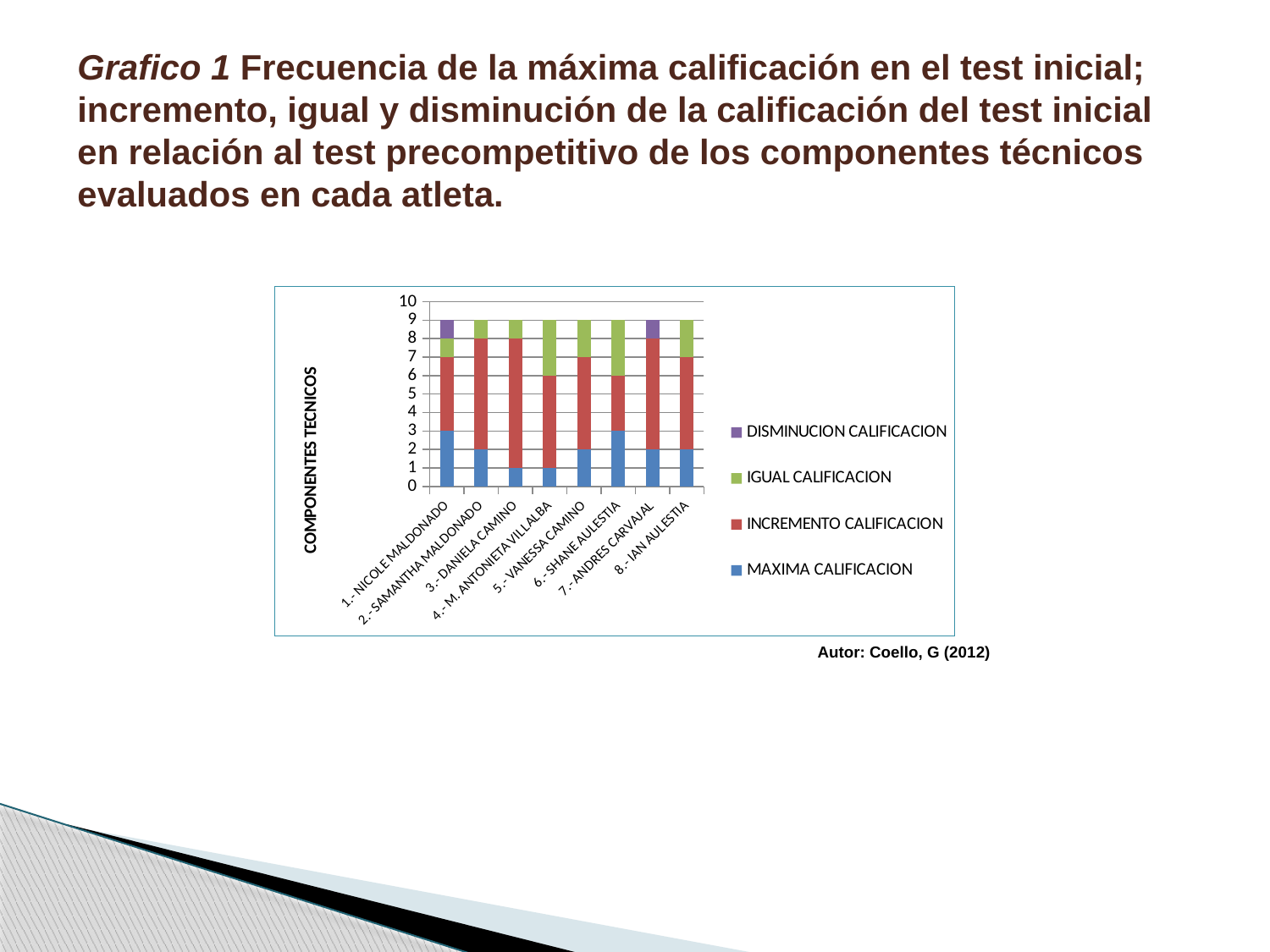
What is the MAXIMA CALIFICACION value for 6.- SHANE AULESTIA? 3 What is the MAXIMA CALIFICACION value for 3.- DANIELA CAMINO? 1 How many athletes' bars include a DISMINUCION CALIFICACION segment? 2 How many athletes (categories) are shown on the x axis of the chart? 8 Which athlete has the larger MAXIMA CALIFICACION value, 1.- NICOLE MALDONADO or 3.- DANIELA CAMINO? 1.- NICOLE MALDONADO How many series does the chart's legend list? 4 What is the IGUAL CALIFICACION value for 4.- M. ANTONIETA VILLALBA? 3 What kind of chart is shown on the slide? bar chart What is the difference between the MAXIMA CALIFICACION values for 6.- SHANE AULESTIA and 8.- IAN AULESTIA? 1 What is the title of the chart's vertical axis? COMPONENTES TECNICOS Is the total stacked value for 2.- SAMANTHA MALDONADO greater or less than 5? greater What is the total height of the stacked bar for 1.- NICOLE MALDONADO? 9